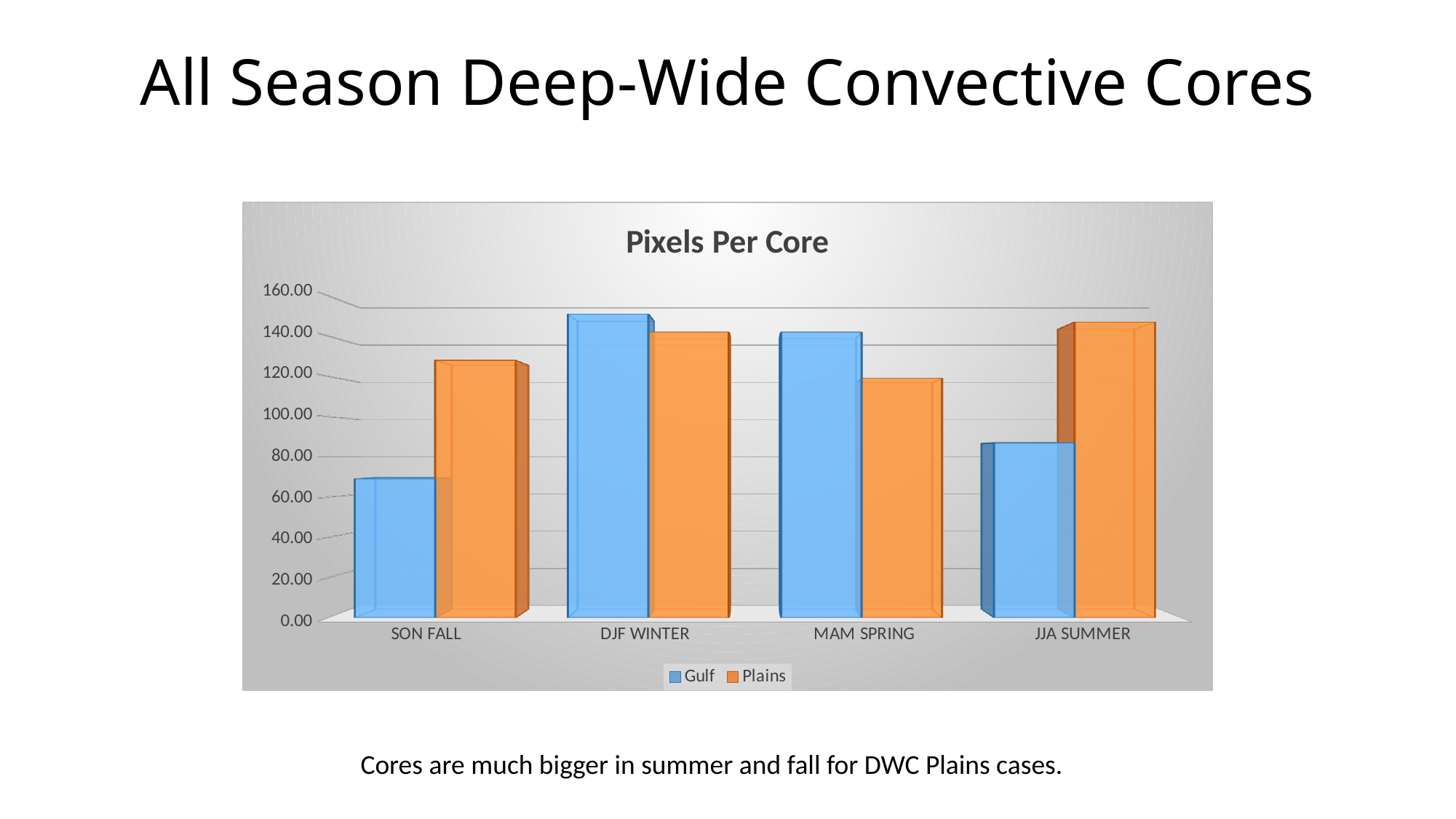
Is the Gulf value for SON FALL greater or less than 80.00? less Is the Plains value for JJA SUMMER greater or less than 120.00? greater How many series does the legend list? 2 What kind of chart is shown on the slide? bar chart For JJA SUMMER, which series has the larger value, Gulf or Plains? Plains Is the Gulf value for JJA SUMMER greater or less than 100.00? less Which season has the lowest Gulf value? SON FALL How many seasons are shown on the x axis? 4 For MAM SPRING, which series has the larger value, Gulf or Plains? Gulf For SON FALL, which series has the larger value, Gulf or Plains? Plains Which series is shown in orange? Plains What is the title of the chart? Pixels Per Core